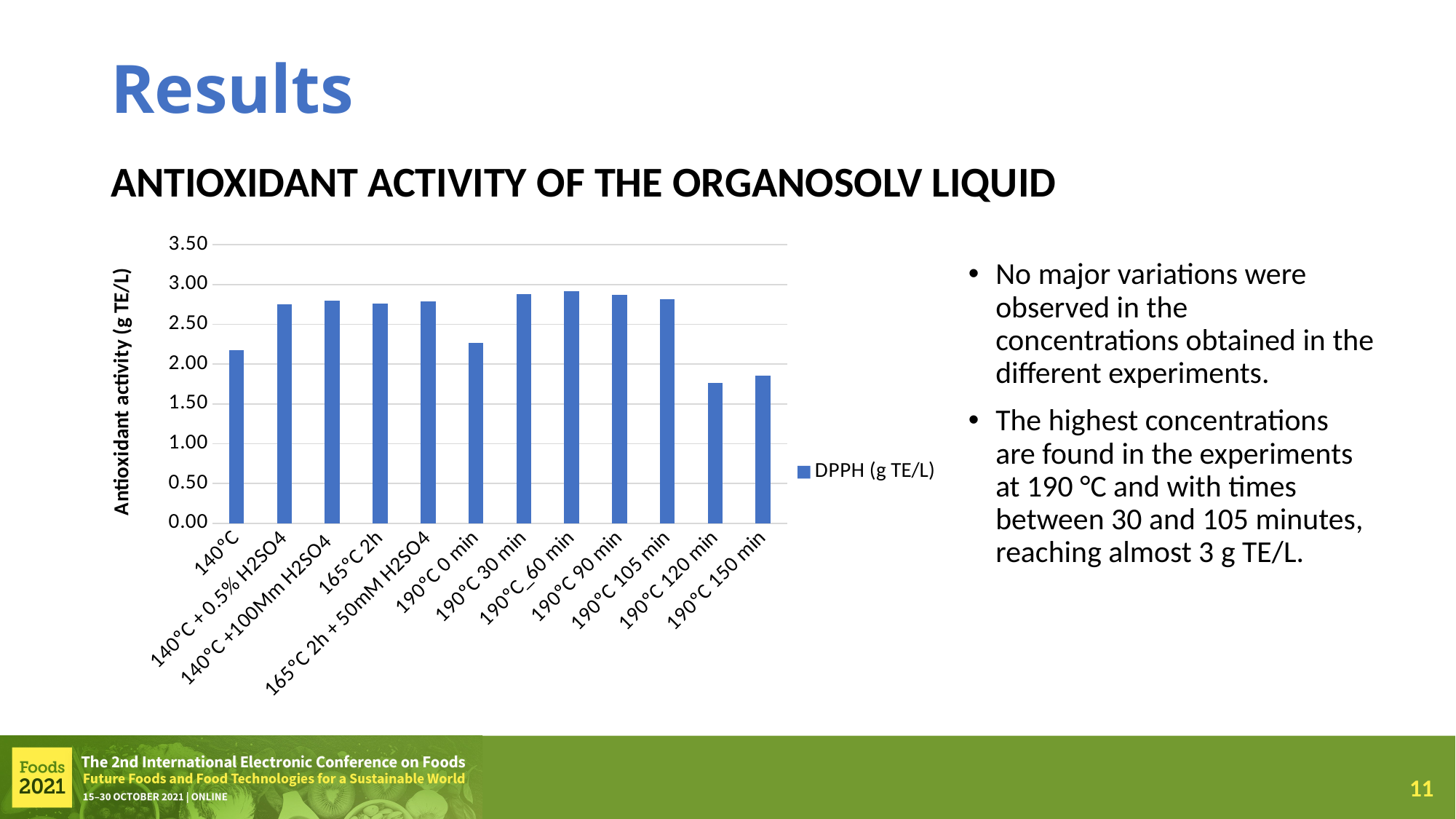
Is the value for 190°C 150 min greater or less than 2.00? less What is the title of the vertical axis of the chart? Antioxidant activity (g TE/L) How many series does the chart legend list? 1 What is the name of the series shown in the chart legend? DPPH (g TE/L) What kind of chart is shown on the slide? bar chart How many categories (bars) are plotted in the chart? 12 Which has a higher value, 190°C 0 min or 190°C 30 min? 190°C 30 min Is the value for 190°C 120 min greater or less than 2.00? less Which has a higher value, 140°C or 140°C + 0.5% H2SO4? 140°C + 0.5% H2SO4 Is the value for 165°C 2h greater or less than 2.50? greater